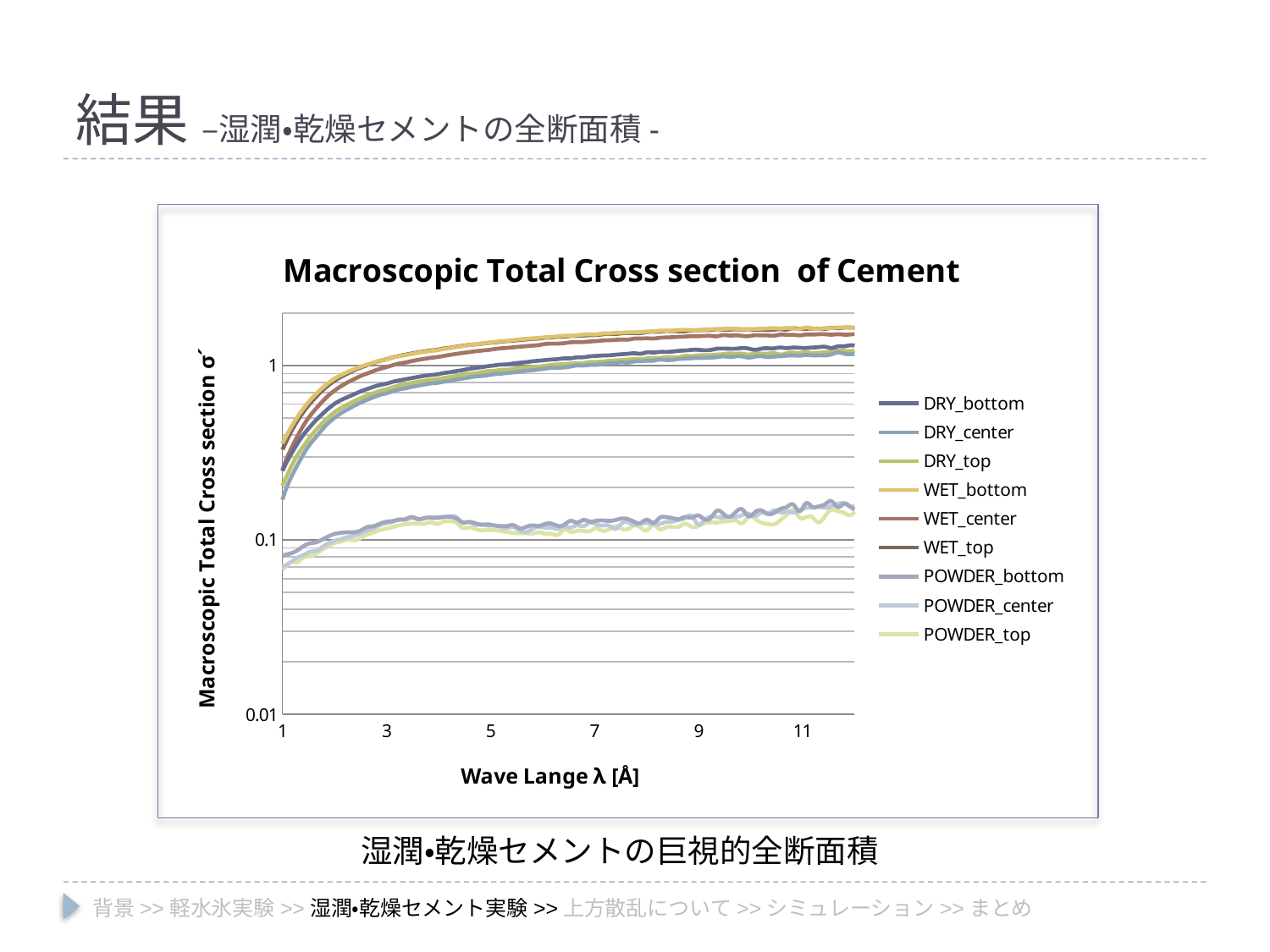
Is the value for POWDER_top at wavelength 11 greater or less than 1? less How many series does the legend list? 9 Is the value for WET_center at wavelength 1 greater or less than 1? less What kind of chart is shown on the slide? line chart What is the title of the chart? Macroscopic Total Cross section of Cement Is the value for WET_bottom at wavelength 11 greater or less than 1? greater Do the values for WET_bottom rise or fall as the wavelength increases from 1 to 11? rise What is the label of the x axis? Wave Lange λ [Å] At wavelength 7, which is larger: the value for DRY_bottom or the value for POWDER_center? DRY_bottom At wavelength 9, which is larger: the value for WET_bottom or the value for POWDER_top? WET_bottom